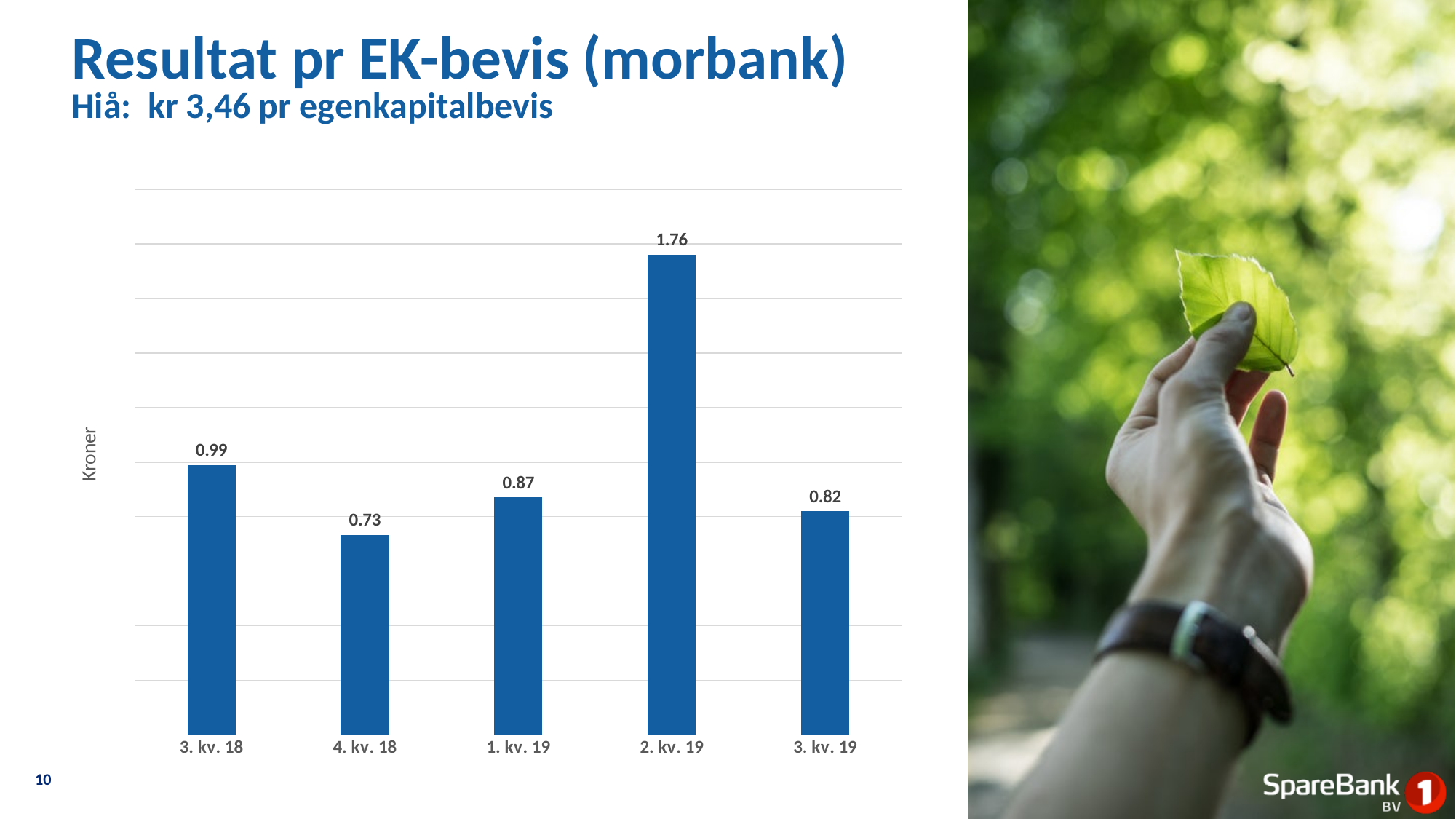
Which is larger, the value for 1. kv. 19 or the value for 3. kv. 19? 1. kv. 19 What is the difference between the values for 2. kv. 19 and 3. kv. 19? 0.94 Which quarter has the highest value? 2. kv. 19 What is the label on the vertical axis of the chart? Kroner What is the value for 3. kv. 19? 0.82 What is the value for 2. kv. 19? 1.76 What kind of chart is shown on the slide? Bar chart Does the value rise or fall from 2. kv. 19 to 3. kv. 19? Fall What is the difference between the values for 3. kv. 18 and 4. kv. 18? 0.26 How many quarters are shown on the chart? 5 What is the value for 4. kv. 18? 0.73 Which quarter has the lowest value? 4. kv. 18